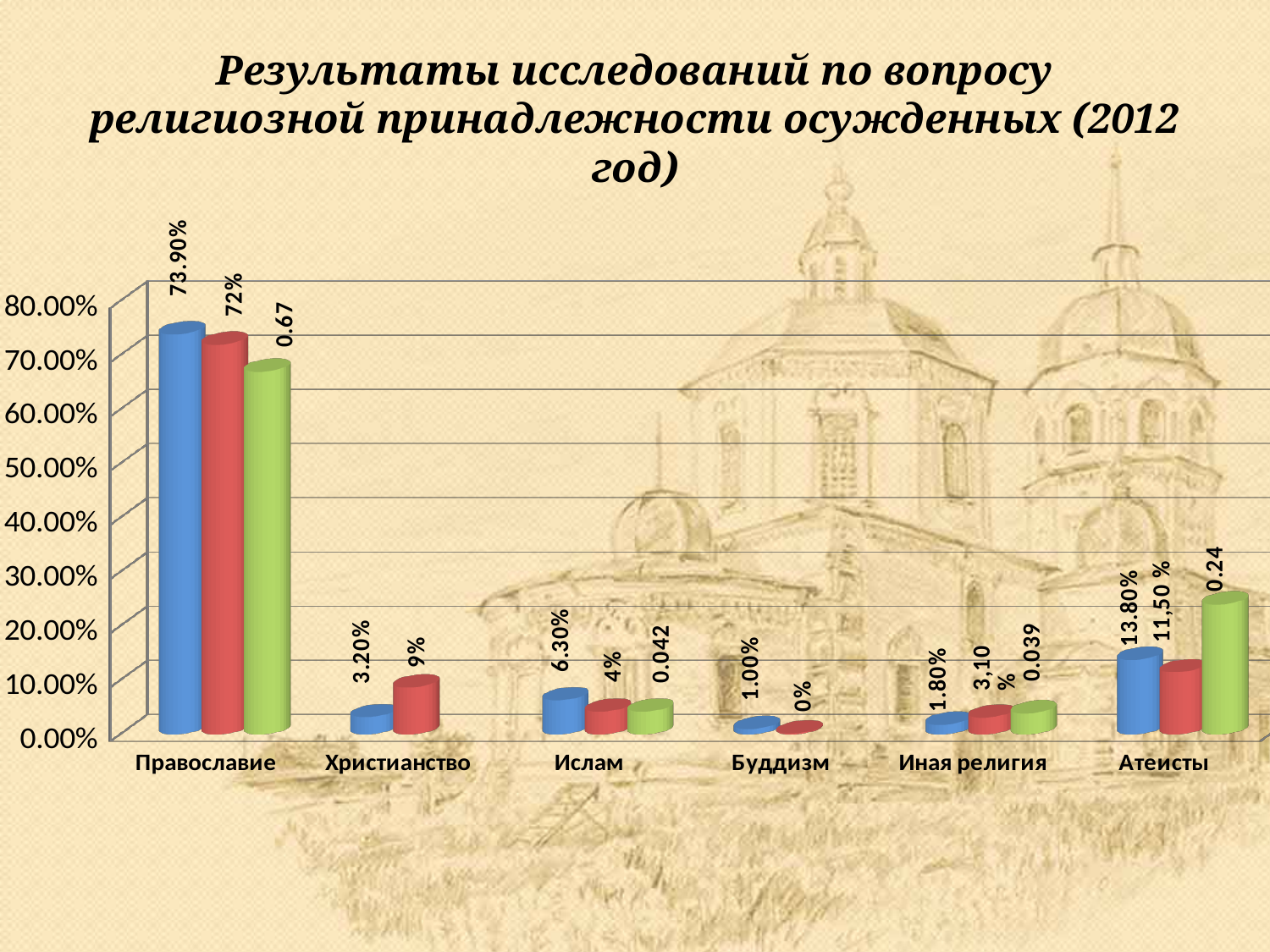
What is the value of the blue bar for Православие? 73.90% What is the difference between the blue bar values for Православие and Атеисты? 60.10% What kind of chart is shown on the slide? bar chart What is the value of the red bar for Христианство? 9% What is the value of the green bar for Атеисты? 0.24 Which category has the highest blue bar? Православие Which category has the lowest blue bar? Буддизм Is the value of the blue bar for Православие greater or less than 70.00%? greater What is the value of the blue bar for Ислам? 6.30% For Христианство, which is larger: the blue bar or the red bar? the red bar How many categories are shown on the x axis? 6 What is the value of the red bar for Буддизм? 0%